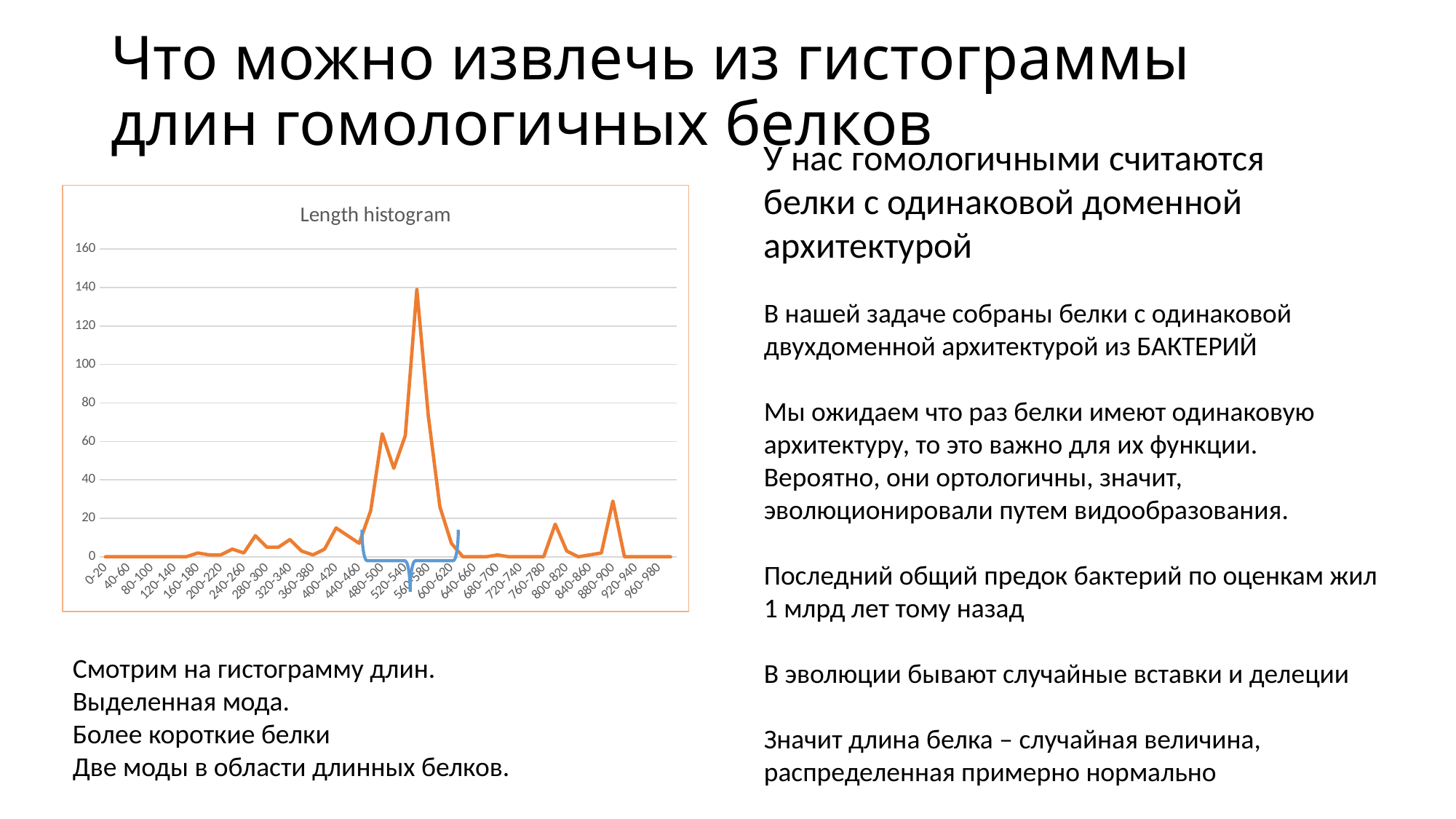
In the "Length histogram" chart, is the value for 880-900 greater or less than 20? greater In the "Length histogram" chart, is the value for 480-500 greater or less than 40? greater What is the title of the chart on the slide? Length histogram In the "Length histogram" chart, is the value for 880-900 greater or less than 40? less In the "Length histogram" chart, which has the larger value: 560-580 or 480-500? 560-580 What kind of chart is the "Length histogram" chart? line chart In the "Length histogram" chart, which has the larger value: 480-500 or 880-900? 480-500 In the "Length histogram" chart, do the values rise or fall from 560-580 to 640-660? fall What colour is the line in the "Length histogram" chart? orange